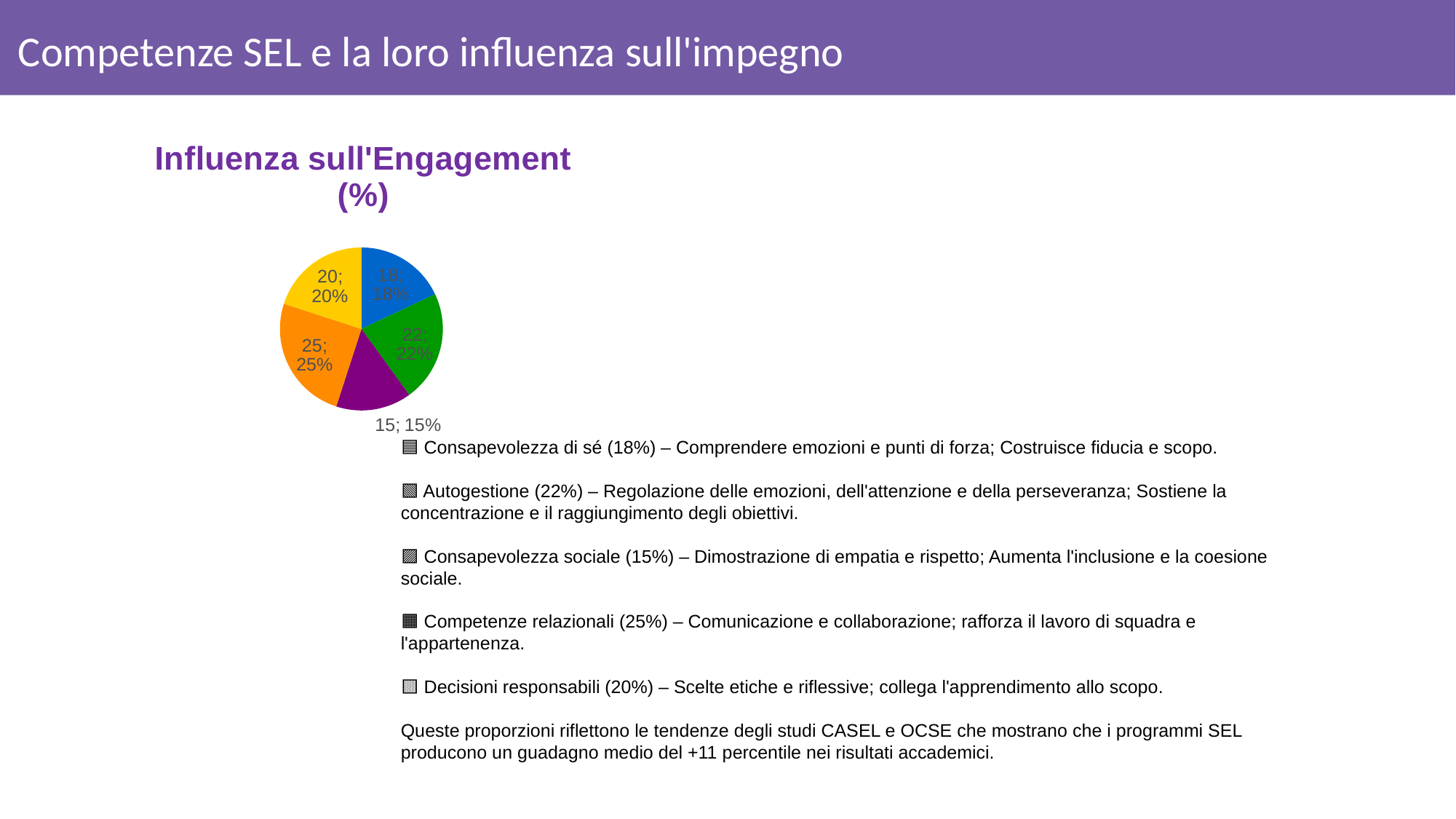
What is the largest value shown in the pie chart? 25 What is the smallest value shown in the pie chart? 15 What share of the pie does the purple slice represent? 15% What kind of chart is shown on the slide? Pie chart What percentage is shown on the yellow slice of the pie chart? 20% Which slice is larger, the green slice or the blue slice? Green slice What is the title of the chart? Influenza sull'Engagement (%) What percentage is shown on the orange slice of the pie chart? 25% What percentage is shown on the green slice of the pie chart? 22% How many slices does the pie chart have? 5 What percentage is shown on the blue slice of the pie chart? 18% What is the difference between the largest slice value (25) and the smallest slice value (15)? 10